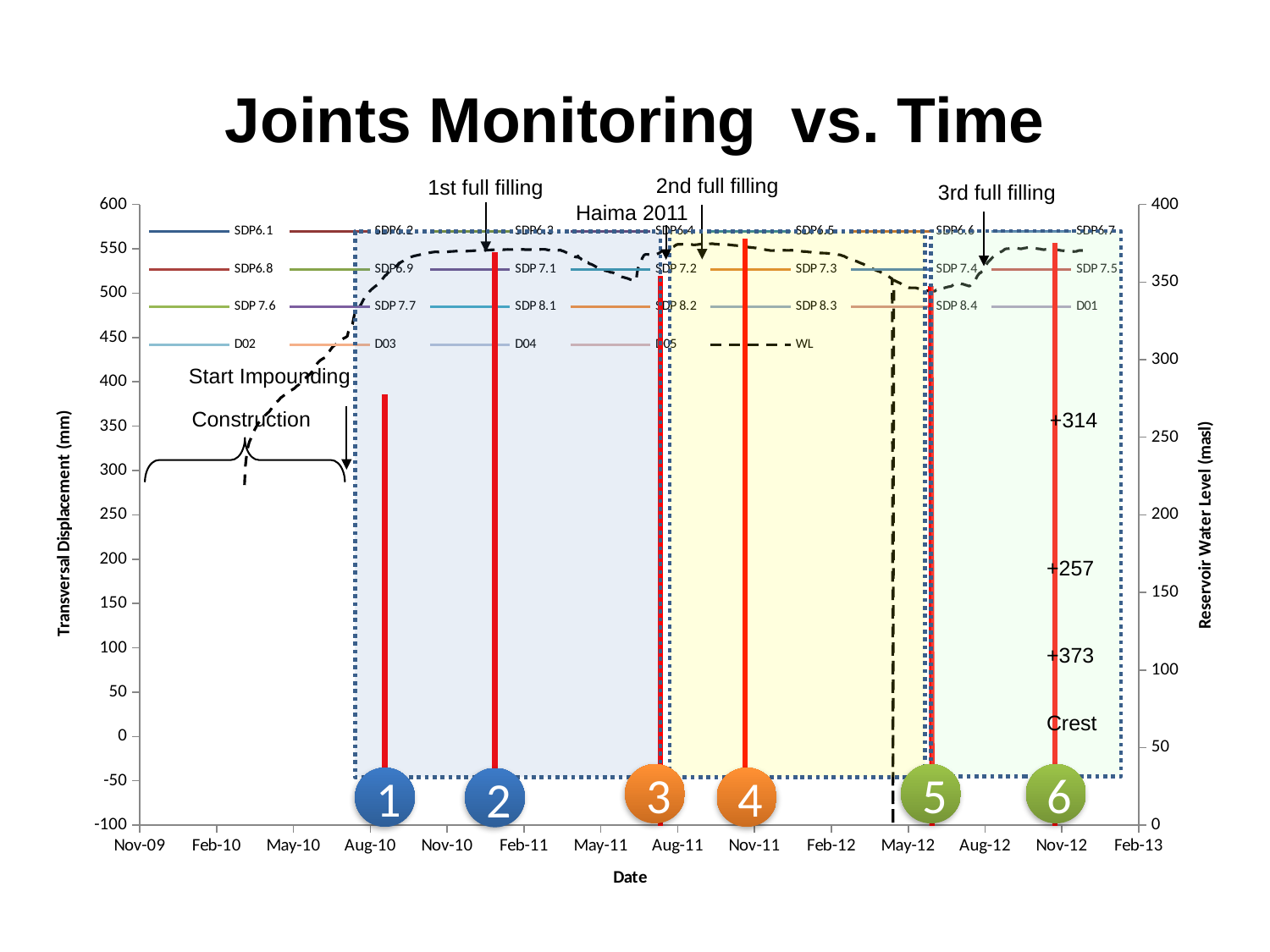
Does the WL series rise or fall between Feb-10 and Nov-10? rise Which legend series is drawn as a dashed line? WL How many series does the chart's legend list? 26 What kind of chart is shown on the slide? line chart On the right-hand axis, is the WL value at Nov-10 greater or less than 350? greater On the right-hand axis, is the WL value at Feb-10 greater or less than 300? less Does the WL series rise or fall between Nov-11 and Feb-12? fall What is the title of the chart? Joints Monitoring vs. Time On the right-hand axis, is the WL value at Nov-12 greater or less than 350? greater